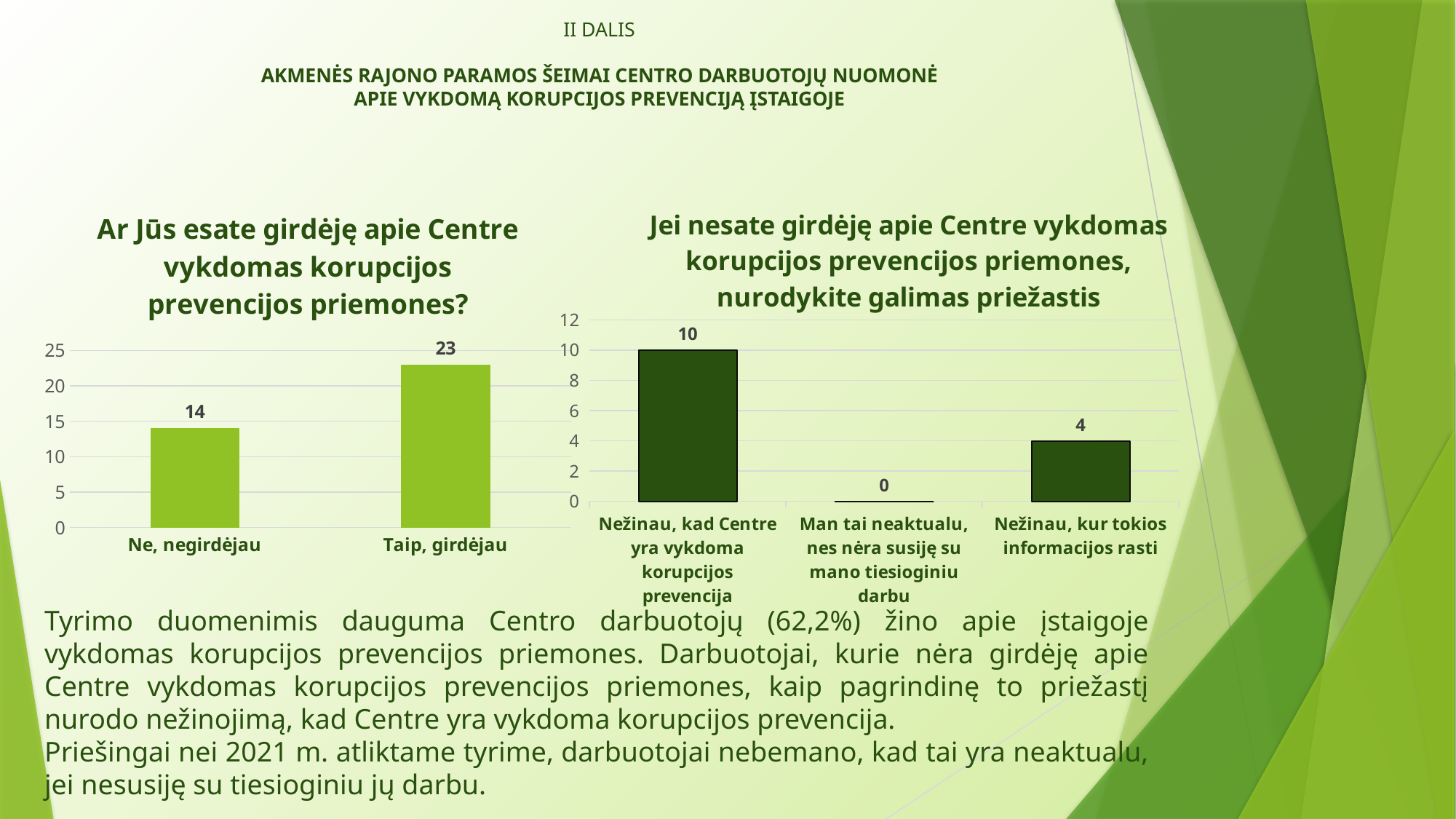
In the right chart 'Jei nesate girdėję apie Centre vykdomas korupcijos prevencijos priemones, nurodykite galimas priežastis', which category has the lowest value? Man tai neaktualu, nes nėra susiję su mano tiesioginiu darbu In the left chart 'Ar Jūs esate girdėję apie Centre vykdomas korupcijos prevencijos priemones?', what is the value for 'Taip, girdėjau'? 23 In the left chart 'Ar Jūs esate girdėję apie Centre vykdomas korupcijos prevencijos priemones?', what is the total of the two bars? 37 In the left chart 'Ar Jūs esate girdėję apie Centre vykdomas korupcijos prevencijos priemones?', what is the value for 'Ne, negirdėjau'? 14 In the right chart 'Jei nesate girdėję apie Centre vykdomas korupcijos prevencijos priemones, nurodykite galimas priežastis', what is the value for 'Nežinau, kur tokios informacijos rasti'? 4 In the left chart 'Ar Jūs esate girdėję apie Centre vykdomas korupcijos prevencijos priemones?', which category has the highest value? Taip, girdėjau In the left chart 'Ar Jūs esate girdėję apie Centre vykdomas korupcijos prevencijos priemones?', what is the difference between 'Taip, girdėjau' and 'Ne, negirdėjau'? 9 In the left chart 'Ar Jūs esate girdėję apie Centre vykdomas korupcijos prevencijos priemones?', how many categories are shown? 2 In the right chart 'Jei nesate girdėję apie Centre vykdomas korupcijos prevencijos priemones, nurodykite galimas priežastis', what is the difference between 'Nežinau, kad Centre yra vykdoma korupcijos prevencija' and 'Nežinau, kur tokios informacijos rasti'? 6 In the right chart 'Jei nesate girdėję apie Centre vykdomas korupcijos prevencijos priemones, nurodykite galimas priežastis', what is the value for 'Nežinau, kad Centre yra vykdoma korupcijos prevencija'? 10 In the right chart 'Jei nesate girdėję apie Centre vykdomas korupcijos prevencijos priemones, nurodykite galimas priežastis', how many categories are shown? 3 What type of chart is the right chart 'Jei nesate girdėję apie Centre vykdomas korupcijos prevencijos priemones, nurodykite galimas priežastis'? Bar chart